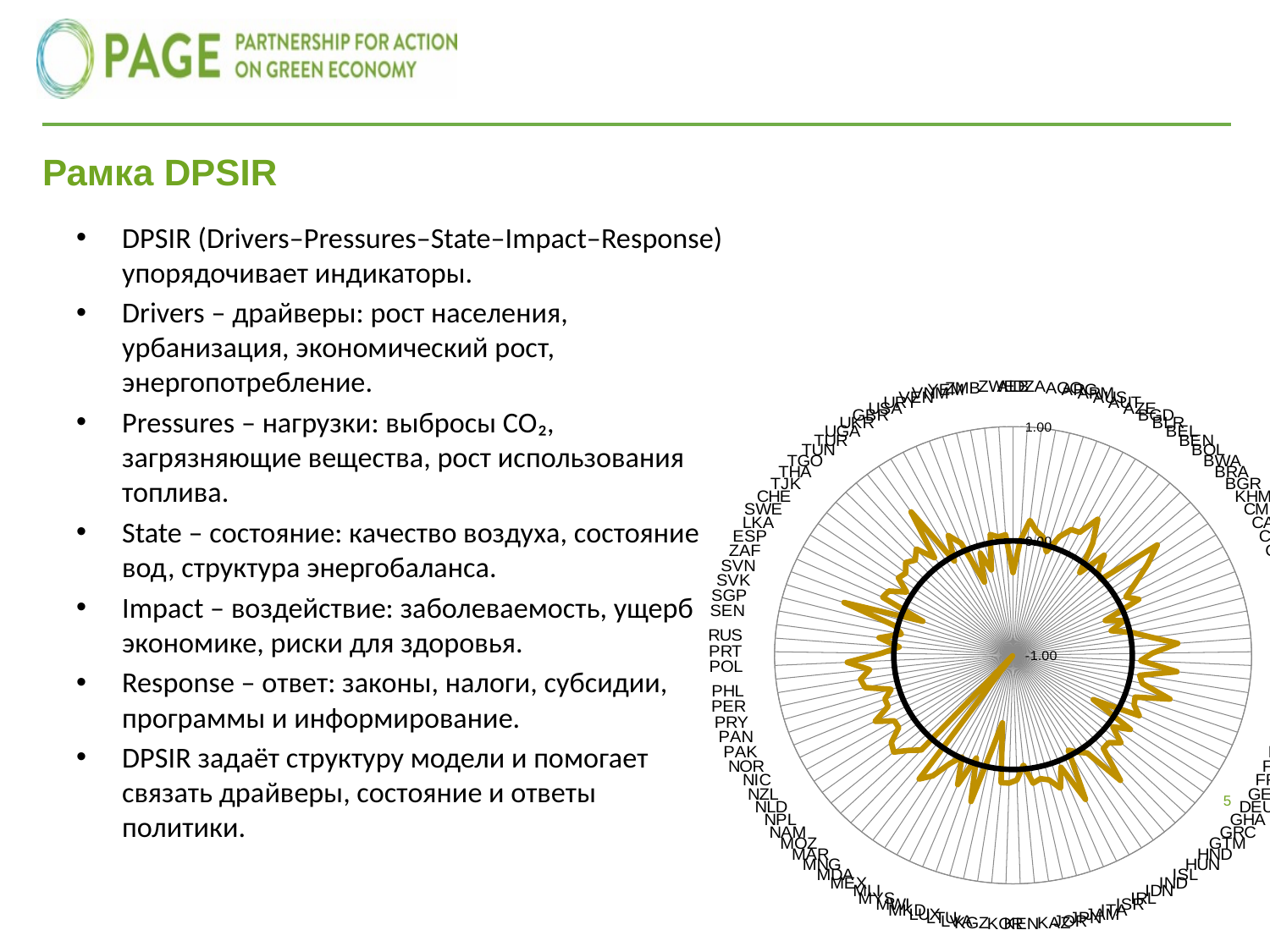
Is the value for SEN on the gold line greater or less than 1.00? less What is the highest tick value printed on the radial axis of the chart? 1.00 What is the lowest tick value printed on the radial axis of the chart? -1.00 What kind of chart is shown on the slide? radar chart At which axis value does the thick black circle lie? 0.00 Is the value for POL on the gold line greater or less than 1.00? less